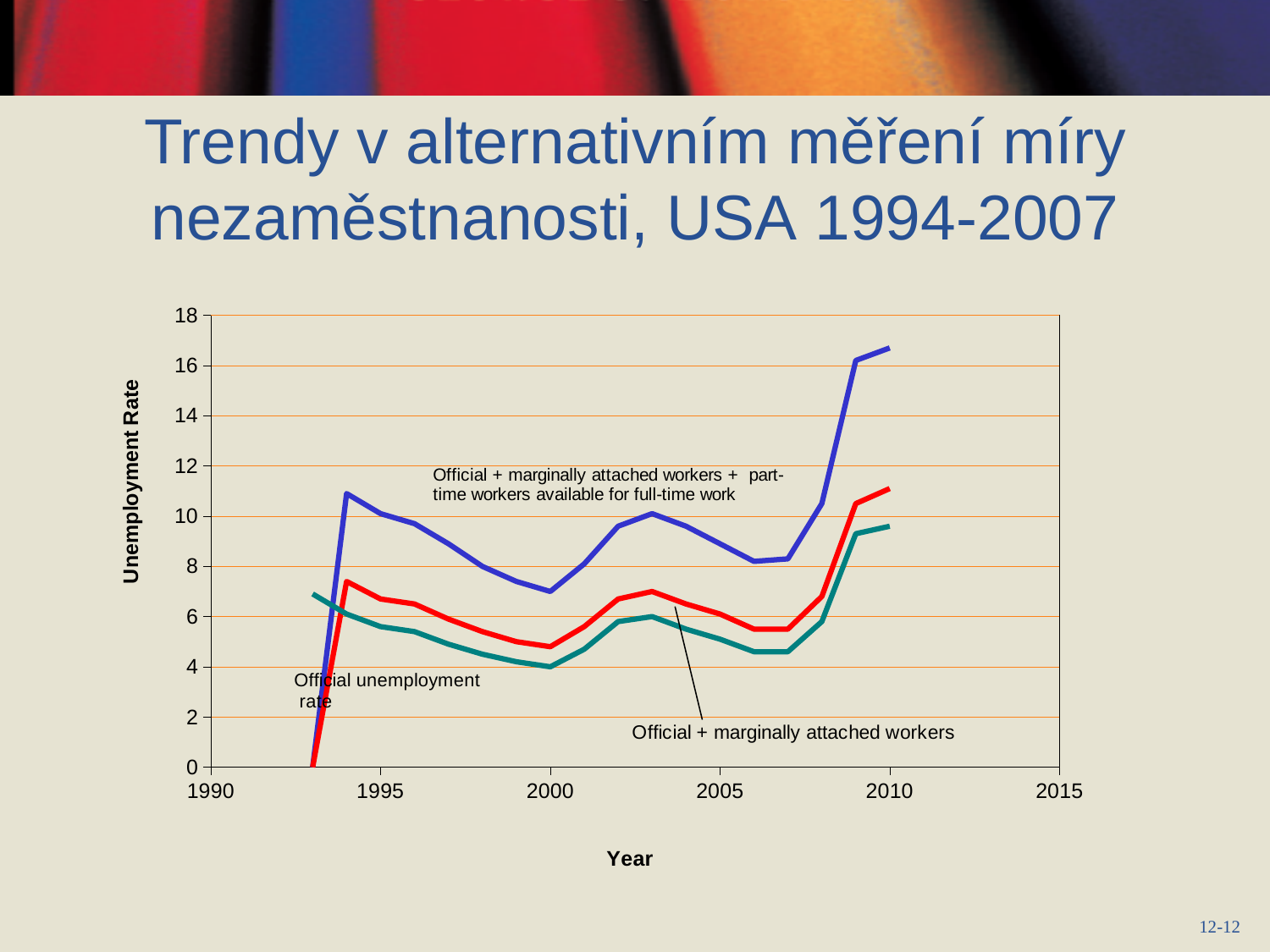
In 2010, which is larger: the 'Official unemployment rate' or the 'Official + marginally attached workers + part-time workers available for full-time work' rate? Official + marginally attached workers + part-time workers available for full-time work Between 2007 and 2010, does the 'Official + marginally attached workers + part-time workers available for full-time work' line rise or fall? rise What is the title of the vertical axis? Unemployment Rate Which line has the highest values throughout the chart? Official + marginally attached workers + part-time workers available for full-time work Is the value of the 'Official unemployment rate' line in 2010 greater or less than 10? less Is the value of the 'Official + marginally attached workers + part-time workers available for full-time work' line in 2010 greater or less than 16? greater What is the title of the horizontal axis? Year What kind of chart is shown on the slide? line chart Is the value of the 'Official + marginally attached workers' line in 2000 greater or less than 6? less How many data series (lines) are plotted on the chart? 3